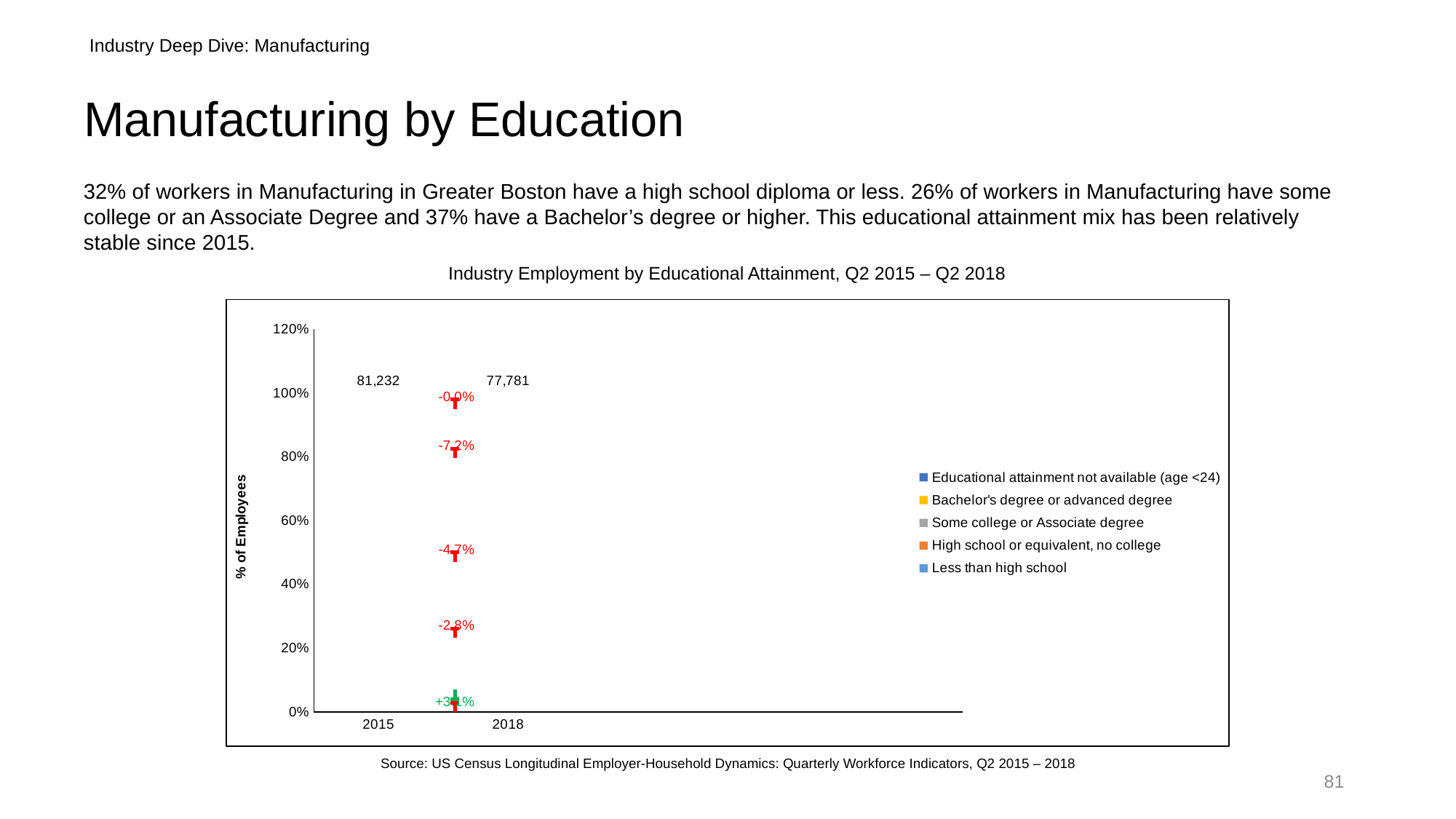
What is the highest tick value shown on the y axis of the chart? 120% How many years are shown on the x axis of the chart? 2 What is the title of the chart? Industry Employment by Educational Attainment, Q2 2015 – Q2 2018 What is the most negative percentage change label printed in red on the chart? -7.2% What total employment figure is printed above the 2018 column in the chart? 77,781 What is the label on the y axis of the chart? % of Employees Which year has the larger total employment figure printed on the chart, 2015 or 2018? 2015 What is the difference between the total employment figures printed for 2015 and 2018? 3,451 How many series does the chart's legend list? 5 Which legend entry in the chart refers to workers under age 24? Educational attainment not available (age <24) What total employment figure is printed above the 2015 column in the chart? 81,232 Does the total employment figure printed on the chart fall or rise from 2015 to 2018? fall